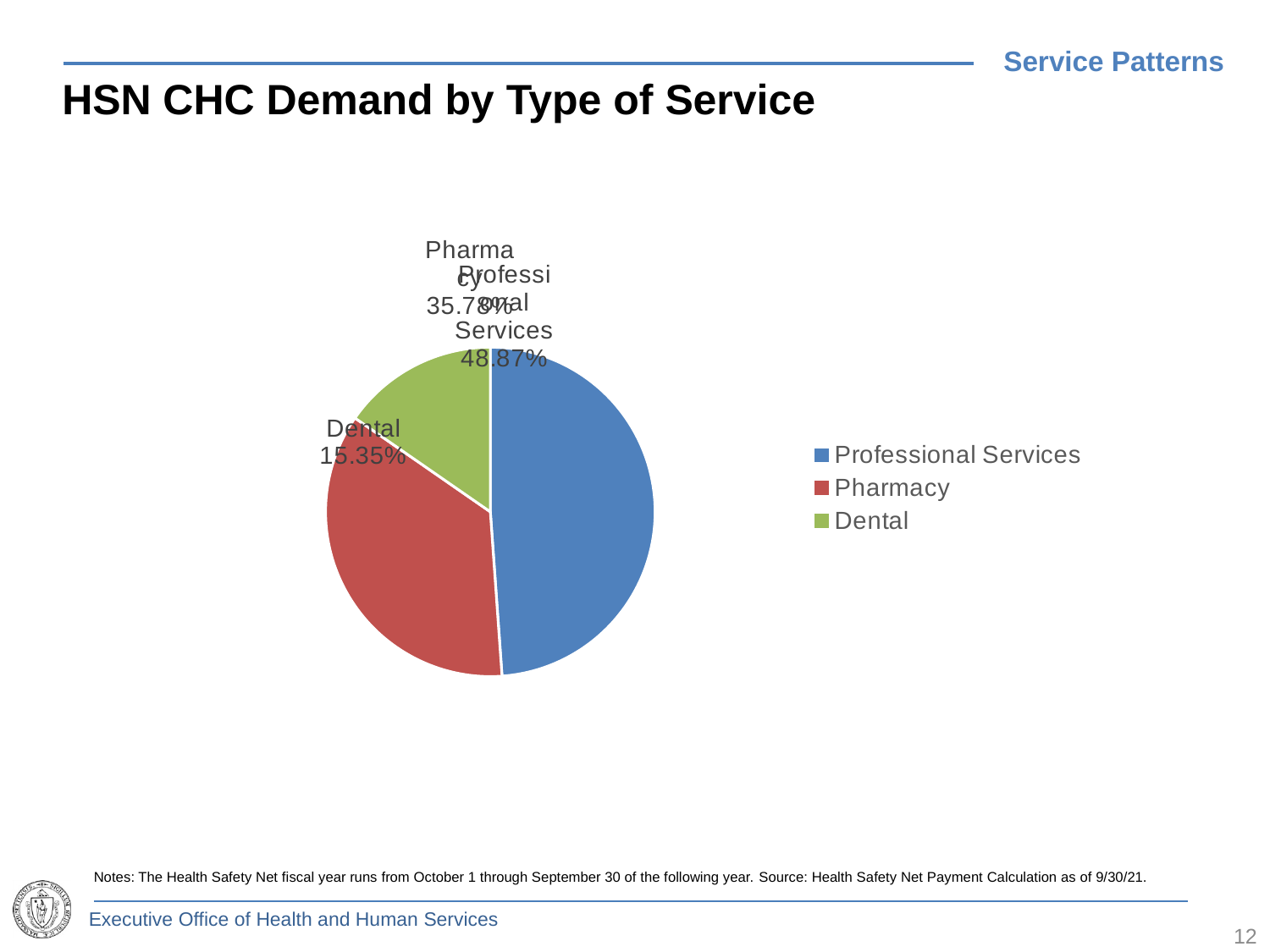
Which is larger, the share for Pharmacy or the share for Dental? Pharmacy What share of the pie is Professional Services? 48.87% How many slices does the pie chart have? 3 How many entries does the legend list? 3 Which type of service has the smallest share of the pie? Dental What share of the pie is Dental? 15.35% Which colour represents Pharmacy in the pie chart? red What is the title of the chart on the slide? HSN CHC Demand by Type of Service What is the difference between the Professional Services share and the Dental share? 33.52% What share of the pie is Pharmacy? 35.78% What kind of chart is shown on the slide? pie chart Which type of service has the largest share of the pie? Professional Services